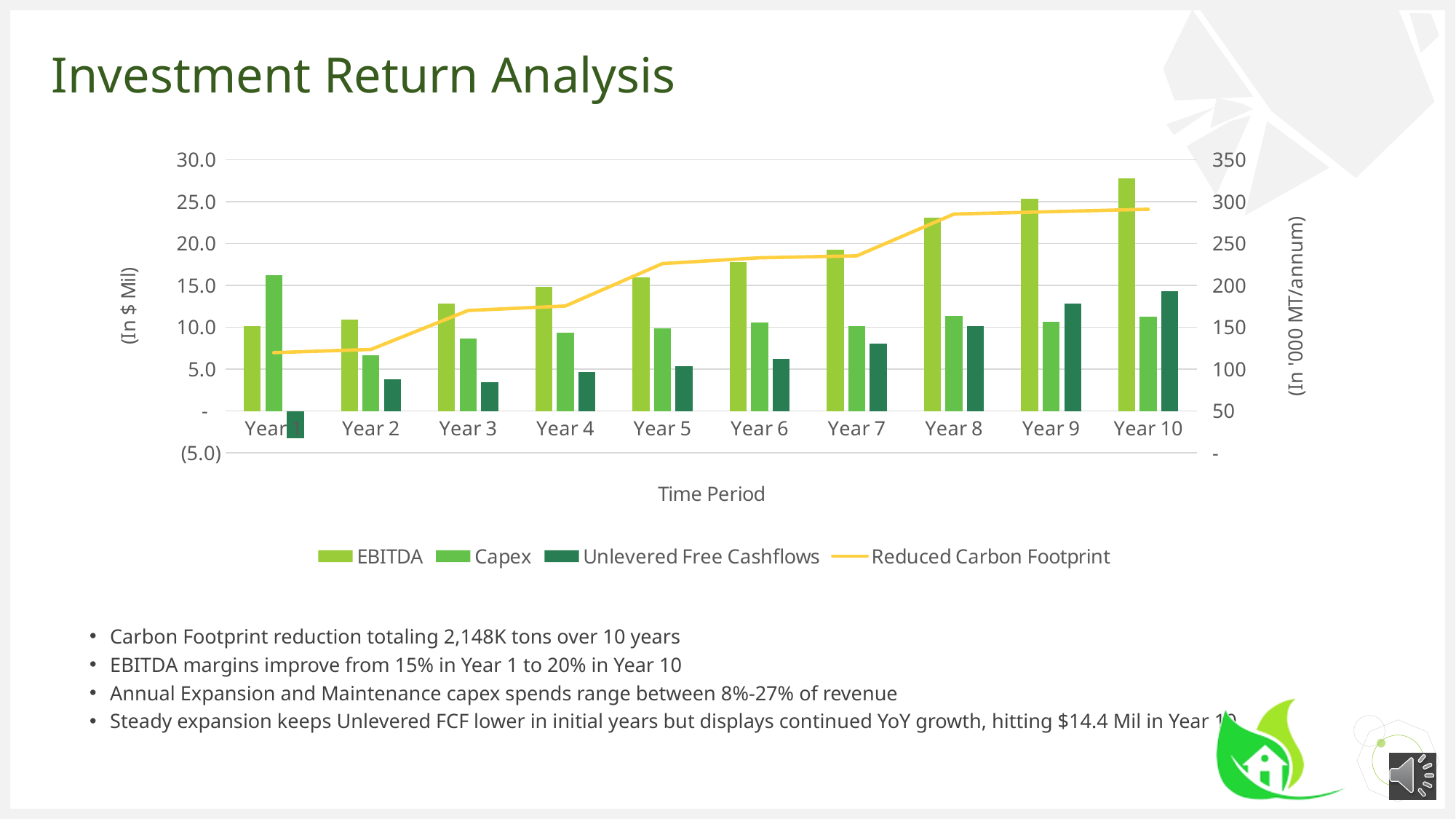
Is the EBITDA value for Year 10 greater or less than 25.0? greater In which year are Unlevered Free Cashflows lowest? Year 1 Does EBITDA rise or fall from Year 1 to Year 10? rise In Year 1, which is larger: EBITDA or Capex? Capex Is the Capex value for Year 2 greater or less than 10.0? less How many time periods (categories) are shown on the x axis? 10 In which year is Capex highest? Year 1 Is the Reduced Carbon Footprint value for Year 10 greater or less than 250? greater What kind of chart is shown on the slide? bar chart with a line In which year is EBITDA lowest? Year 1 In which year is EBITDA highest? Year 10 How many series does the legend list? 4